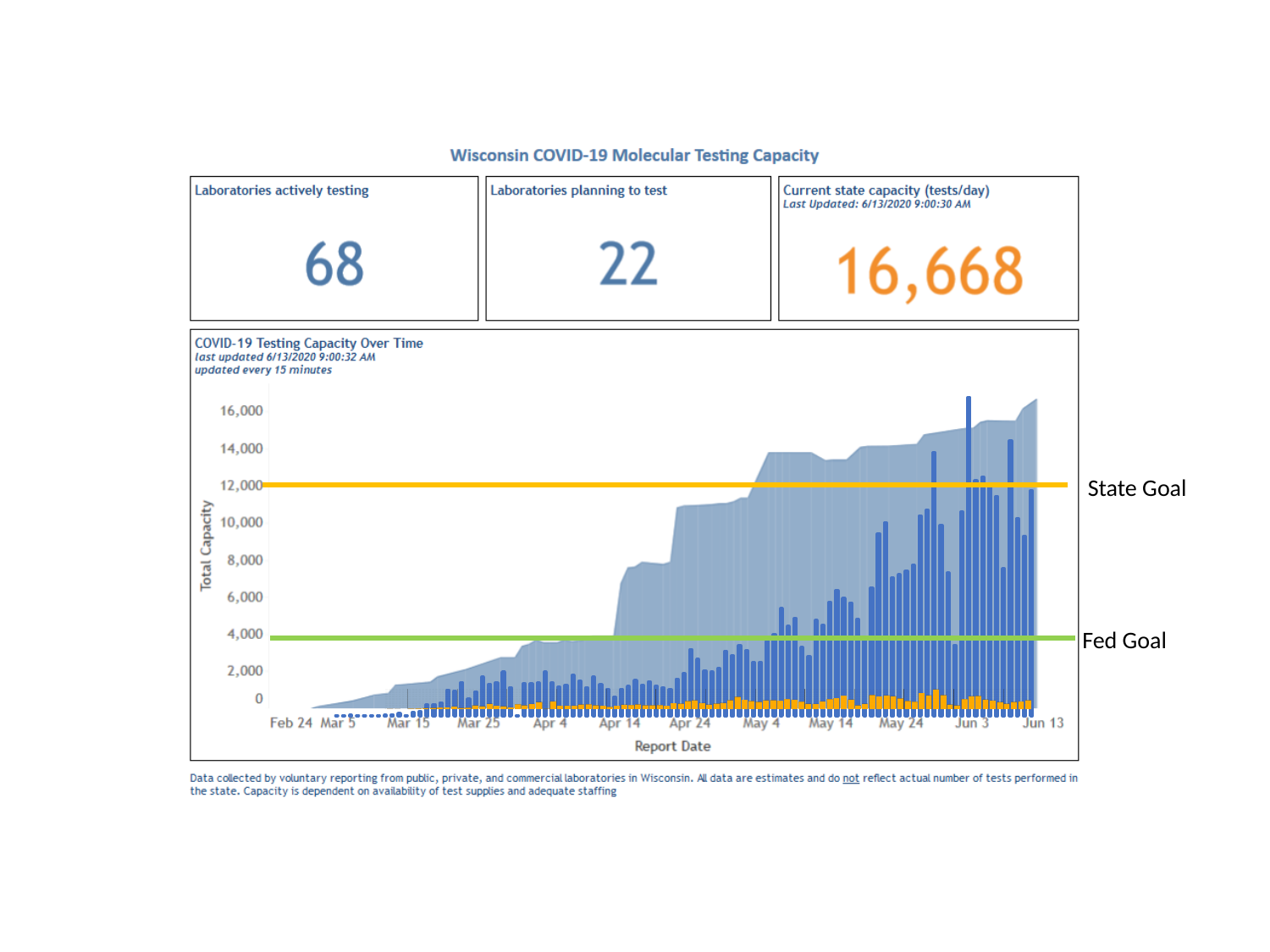
On the COVID-19 Testing Capacity Over Time chart, is the Fed Goal line greater or less than 6,000? less On the COVID-19 Testing Capacity Over Time chart, is the shaded total capacity area at Mar 25 greater or less than 4,000? less On the COVID-19 Testing Capacity Over Time chart, does the shaded total capacity area rise or fall from Feb 24 to Jun 13? rise What is the label of the y axis on the COVID-19 Testing Capacity Over Time chart? Total Capacity On the COVID-19 Testing Capacity Over Time chart, at what Total Capacity level is the State Goal line drawn? 12,000 What is the title of the chart at the bottom of the slide? COVID-19 Testing Capacity Over Time How many laboratories are planning to test according to the slide? 22 What is the current state capacity (tests/day) shown on the slide? 16,668 How many date labels are shown on the x axis of the COVID-19 Testing Capacity Over Time chart? 12 How many laboratories are actively testing according to the slide? 68 On the COVID-19 Testing Capacity Over Time chart, is the shaded total capacity area at Jun 13 greater or less than 16,000? greater